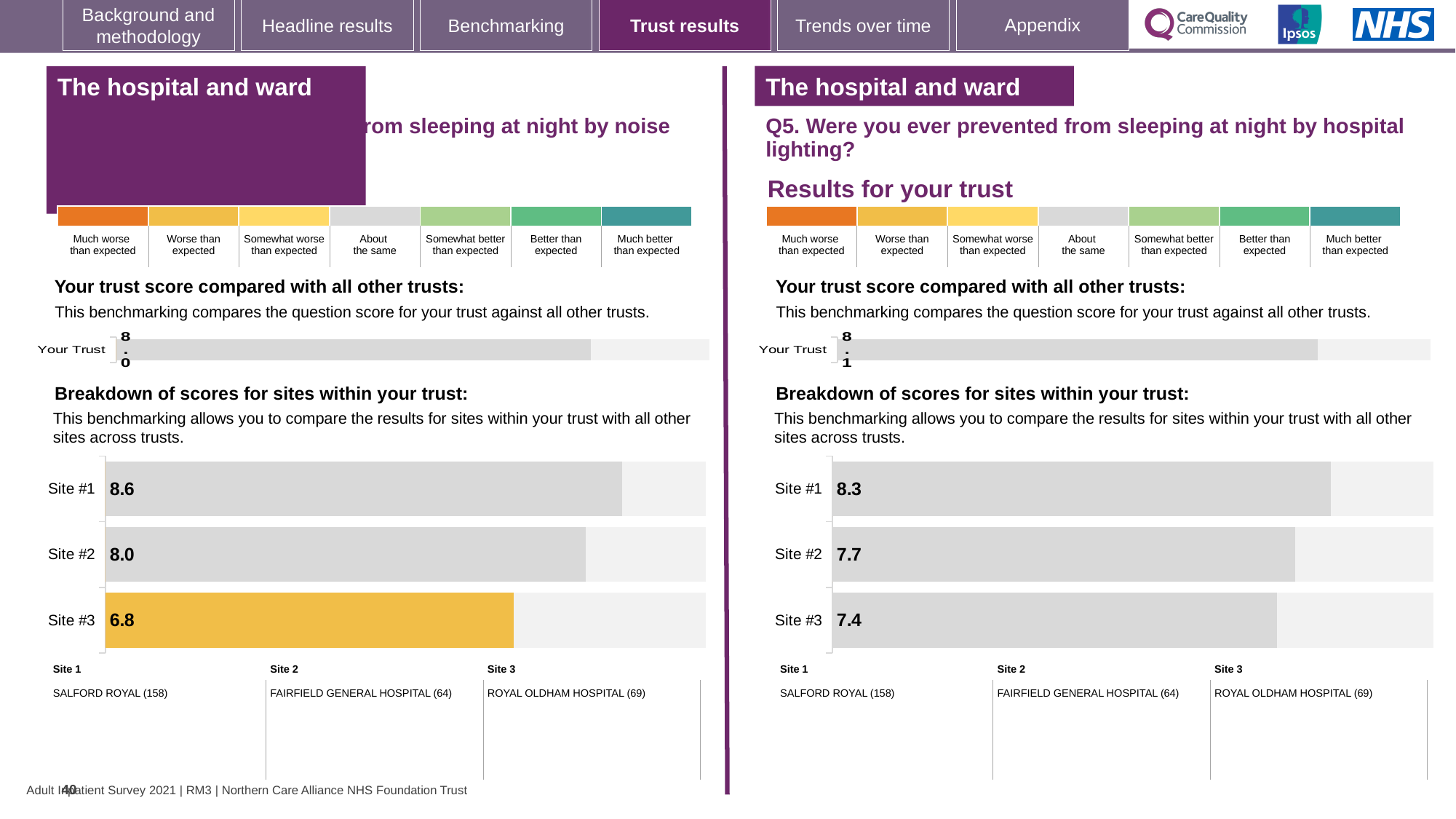
In the left-hand chart (prevented from sleeping at night by noise), what is the score for Site #3? 6.8 In the right-hand chart (Q5, hospital lighting), which site has the lowest score? Site #3 In the left-hand chart (prevented from sleeping at night by noise), what is the difference between the Site #1 and Site #3 scores? 1.8 In the right-hand chart (Q5, hospital lighting), what is the score for Site #1? 8.3 How many sites are shown in the site breakdown chart on the right-hand side (Q5, hospital lighting)? 3 In the left-hand chart (prevented from sleeping at night by noise), what is the score for Site #2? 8.0 In the right-hand chart (Q5, hospital lighting), what is the difference between the Site #1 and Site #2 scores? 0.6 What type of chart is used for the breakdown of scores for sites within the trust? Bar chart In the right-hand chart (Q5, hospital lighting), what is the 'Your Trust' score? 8.1 In the left-hand chart (prevented from sleeping at night by noise), which site has the highest score? Site #1 Which is larger: the Site #2 score in the left-hand chart (noise) or the Site #2 score in the right-hand chart (hospital lighting)? Left-hand chart (noise), 8.0 In the right-hand chart (Q5, hospital lighting), what is the score for Site #3? 7.4